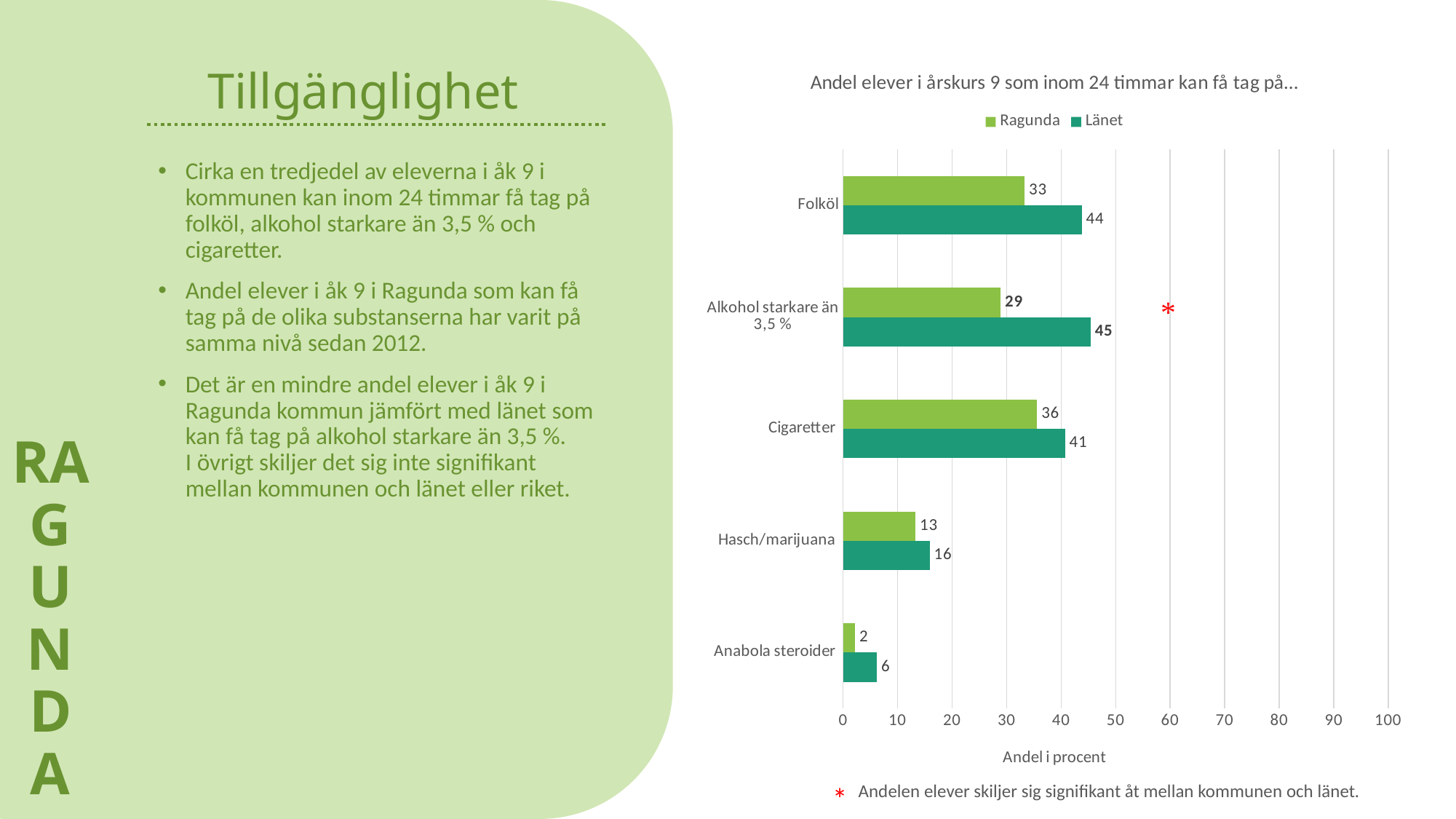
What is the Länet value for Alkohol starkare än 3,5 %? 45 What is the Ragunda value for Folköl? 33 How many categories are shown on the chart? 5 What kind of chart is shown on the slide? Bar chart What is the label of the x axis of the chart? Andel i procent Which category has the lowest Ragunda value? Anabola steroider What is the difference between the Länet and Ragunda values for Alkohol starkare än 3,5 %? 16 What is the difference between the Länet and Ragunda values for Cigaretter? 5 Which is larger for Anabola steroider, the Ragunda value or the Länet value? Länet How many series does the legend list? 2 What is the Ragunda value for Hasch/marijuana? 13 Which category has the highest Länet value? Alkohol starkare än 3,5 %